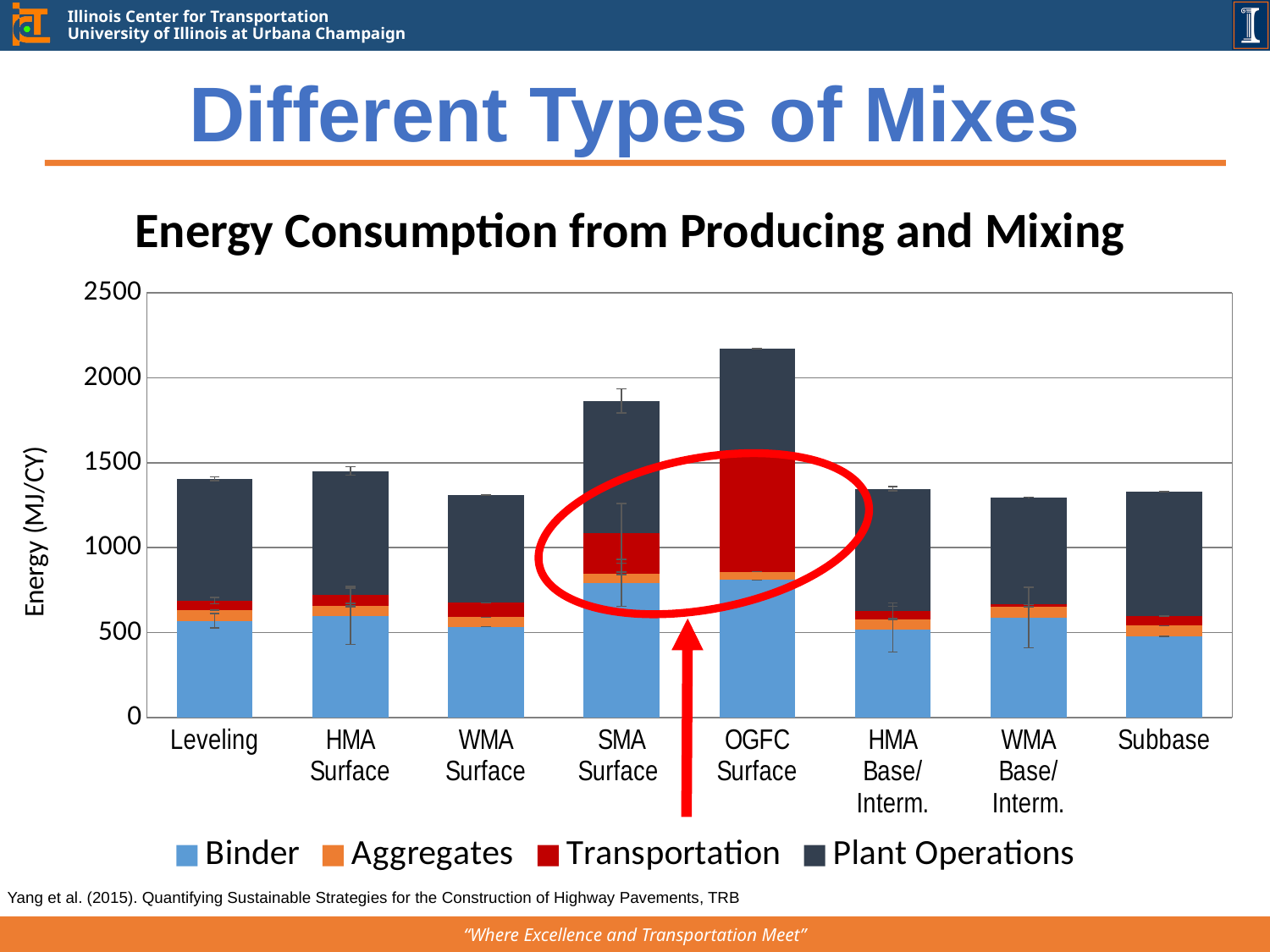
Is the total energy consumption for OGFC Surface greater or less than 2000 MJ/CY? greater What is the title of the chart? Energy Consumption from Producing and Mixing Which mix category has the largest Transportation segment? OGFC Surface Is the total energy consumption for SMA Surface greater or less than 1500 MJ/CY? greater Is the total energy consumption for Subbase greater or less than 1500 MJ/CY? less Which series in the legend is shown in red? Transportation Which mix category has the highest total energy consumption? OGFC Surface What kind of chart is shown on the slide? Stacked bar chart How many series does the chart legend list? 4 Which has a larger total energy consumption, SMA Surface or Leveling? SMA Surface How many mix categories are shown on the x axis of the chart? 8